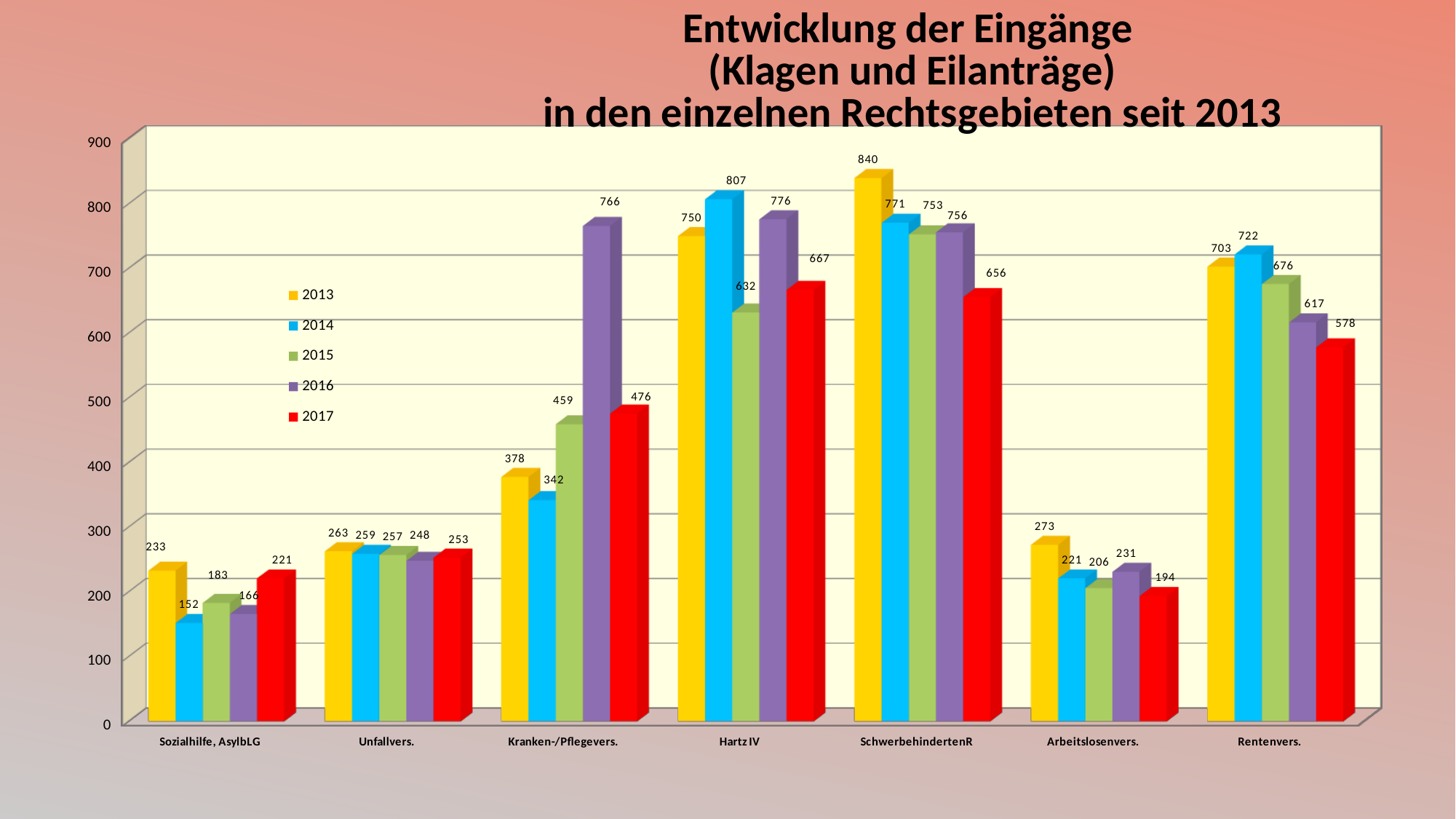
What is the value for Kranken-/Pflegevers. in 2016? 766 Do the values for Rentenvers. rise or fall from 2014 to 2017? fall How many series does the legend list? 5 Which is larger for Arbeitslosenvers.: the 2013 value or the 2016 value? 2013 How many categories are shown on the x axis? 7 Which category has the highest value in 2013? SchwerbehindertenR Which category has the lowest value in 2014? Sozialhilfe, AsylbLG What is the value for Rentenvers. in 2017? 578 What kind of chart is shown on the slide? bar chart What is the value for Hartz IV in 2014? 807 What is the difference between the 2013 and 2017 values for SchwerbehindertenR? 184 Is the value for Kranken-/Pflegevers. in 2015 greater or less than 400? greater